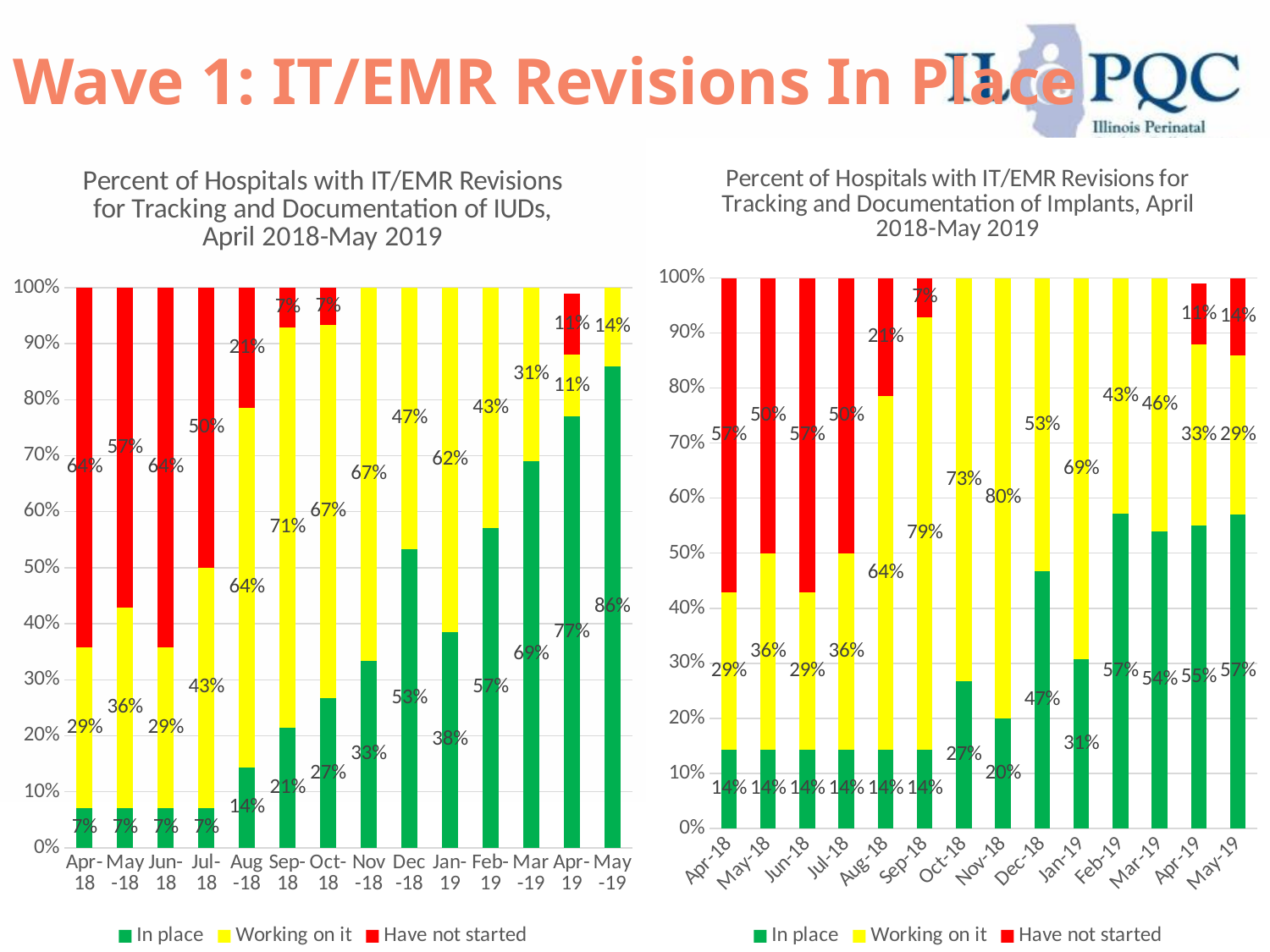
How many series does the legend of the Implants chart on the right list? 3 In the IUDs chart on the left, what is the 'Working on it' value for Sep-18? 71% What type of chart is the Implants chart on the right? Stacked bar chart In the Implants chart on the right, which month has the highest 'Working on it' value? Nov-18 In the Implants chart on the right, what is the 'Working on it' value for Nov-18? 80% In the Implants chart on the right, is the 'In place' value for Feb-19 larger or smaller than the 'In place' value for Mar-19? larger In the IUDs chart on the left, what is the difference between the 'In place' values for Dec-18 and Jan-19? 15% In the IUDs chart on the left, what percent of hospitals had IT/EMR revisions in place in May-19? 86% In the IUDs chart on the left, does the 'Have not started' share generally rise or fall from Apr-18 to May-19? Fall In the IUDs chart on the left, which month has the highest 'In place' value? May-19 How many months are shown on the x axis of the IUDs chart on the left? 14 In the Implants chart on the right, what is the 'In place' value for Dec-18? 47%